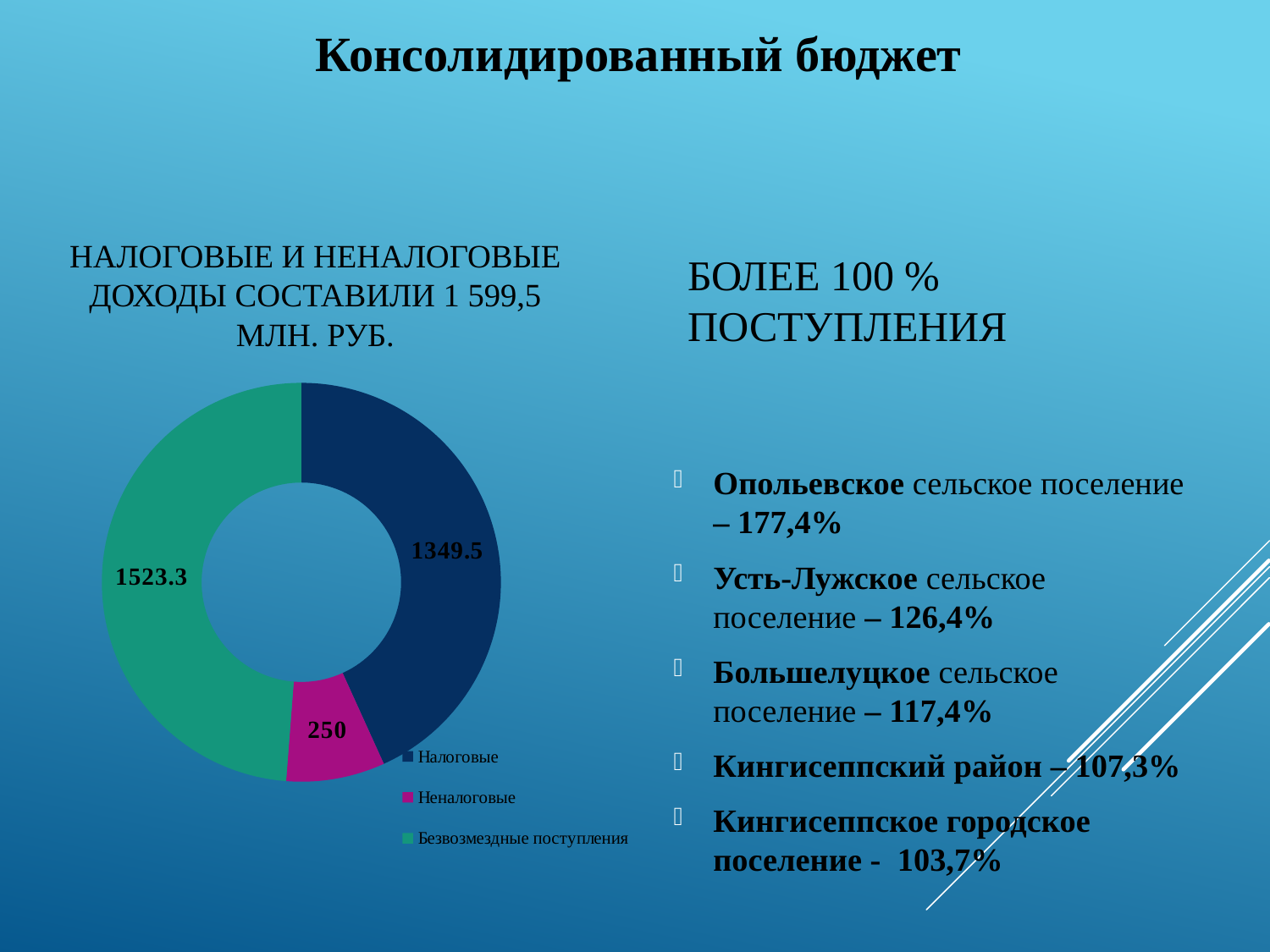
What kind of chart is shown on the slide? doughnut chart Which category has the smallest value in the doughnut chart? Неналоговые What is the value for Неналоговые in the doughnut chart? 250 What is the total of all three values in the doughnut chart? 3122.8 Which is larger, the value for Налоговые or the value for Неналоговые? Налоговые What is the value for Безвозмездные поступления in the doughnut chart? 1523.3 How many entries does the chart legend list? 3 Which category has the largest value in the doughnut chart? Безвозмездные поступления What is the difference between the values for Безвозмездные поступления and Налоговые? 173.8 What is the value for Налоговые in the doughnut chart? 1349.5 What is the difference between the values for Налоговые and Неналоговые? 1099.5 How many categories are shown in the doughnut chart? 3